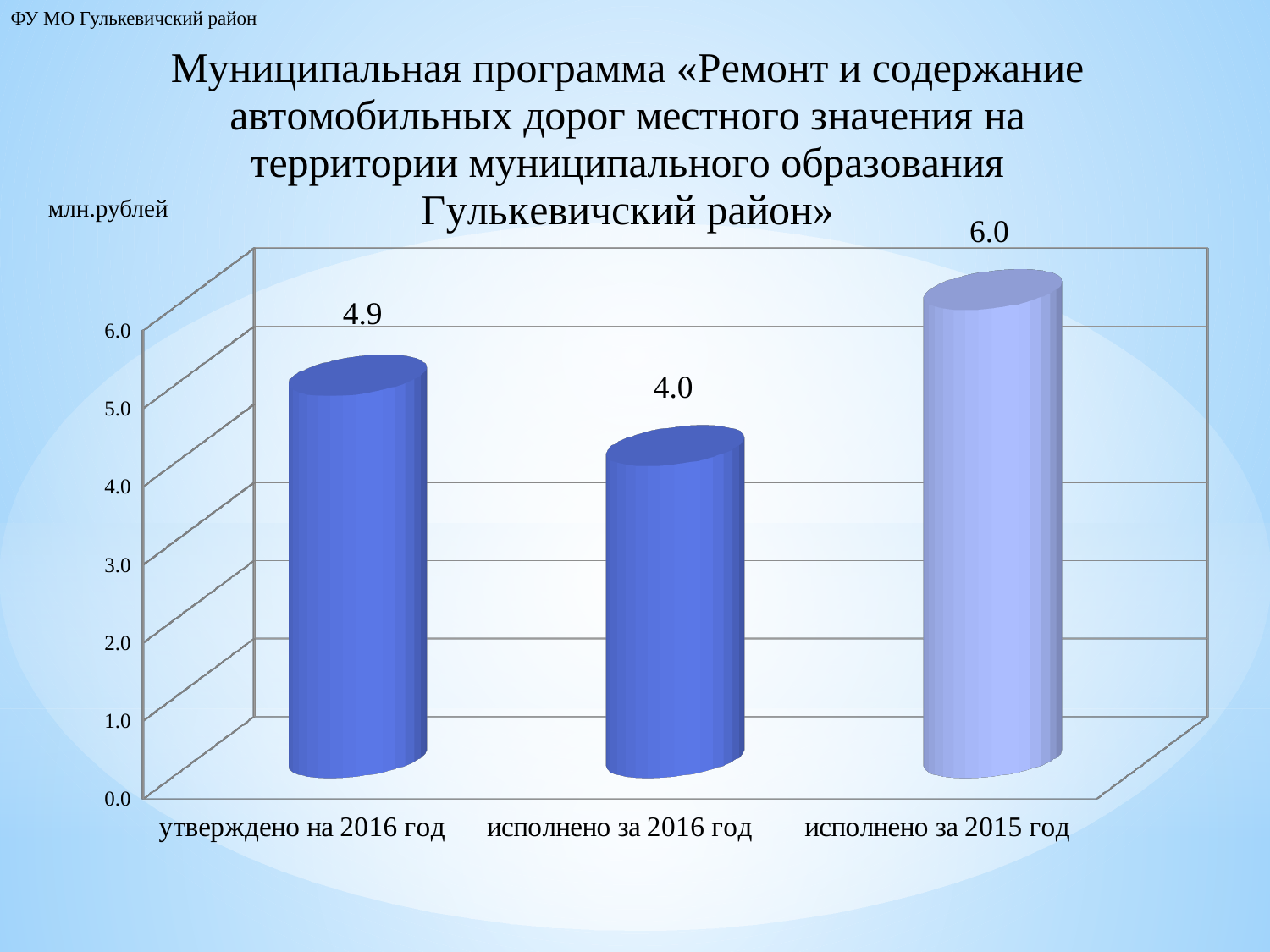
Which category has the highest value? исполнено за 2015 год Which category has the lowest value? исполнено за 2016 год What is the difference between the value for «утверждено на 2016 год» and the value for «исполнено за 2016 год»? 0.9 What kind of chart is shown on the slide? bar chart How many categories are shown on the chart? 3 What is the difference between the value for «исполнено за 2015 год» and the value for «исполнено за 2016 год»? 2.0 What unit of measurement is indicated for the chart values? млн.рублей What is the value for «исполнено за 2015 год»? 6.0 Which is larger: the value for «утверждено на 2016 год» or the value for «исполнено за 2016 год»? утверждено на 2016 год Is the value for «утверждено на 2016 год» greater or less than 5.0? less What is the value for «утверждено на 2016 год»? 4.9 What is the value for «исполнено за 2016 год»? 4.0